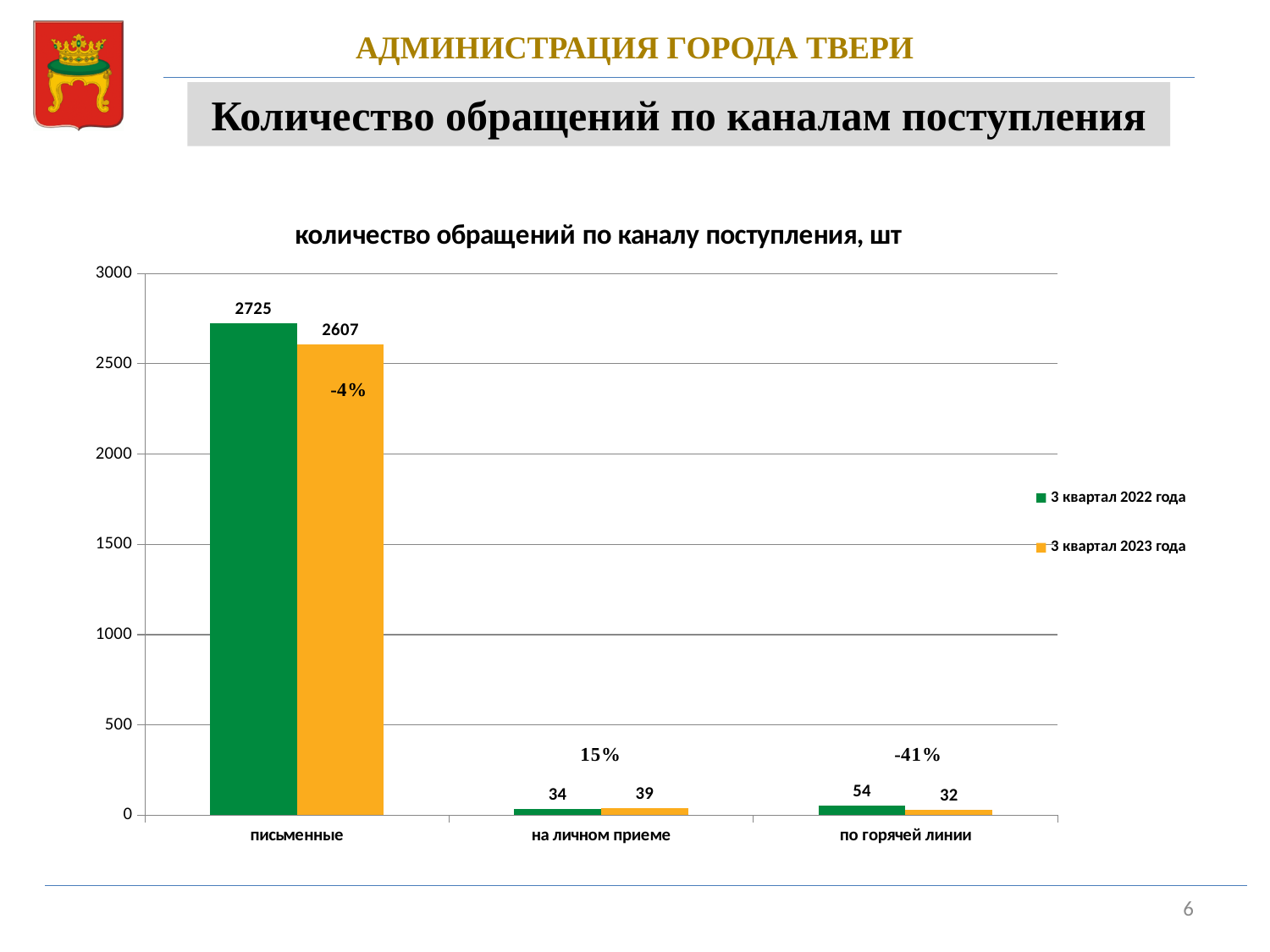
What is the value for письменные in 3 квартал 2023 года? 2607 How many categories are shown on the x axis? 3 What percentage change is labelled above the по горячей линии bars? -41% What is the difference between the 3 квартал 2022 года and 3 квартал 2023 года values for письменные? 118 How many series does the legend list? 2 Which category has the lowest value in 3 квартал 2023 года? по горячей линии What is the value for письменные in 3 квартал 2022 года? 2725 What kind of chart is shown on the slide? bar chart What is the value for по горячей линии in 3 квартал 2022 года? 54 What is the value for на личном приеме in 3 квартал 2023 года? 39 Which category has the highest value in 3 квартал 2022 года? письменные Which is larger for по горячей линии: the 3 квартал 2022 года value or the 3 квартал 2023 года value? 3 квартал 2022 года